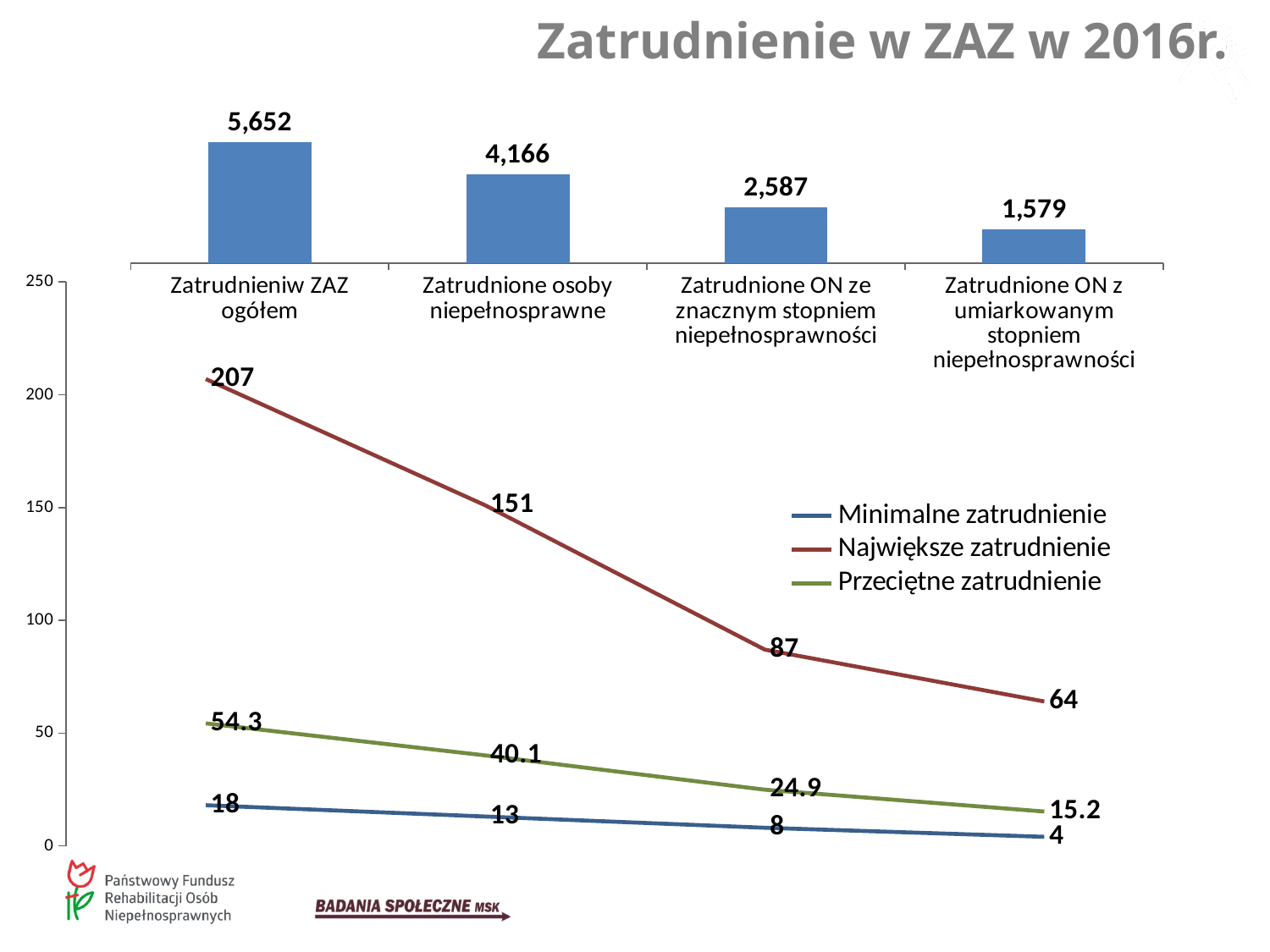
In the line chart at the bottom of the slide, which is larger at 'Zatrudnieniw ZAZ ogółem': 'Przeciętne zatrudnienie' or 'Minimalne zatrudnienie'? Przeciętne zatrudnienie In the bar chart at the top of the slide, what is the difference between 'Zatrudnieniw ZAZ ogółem' and 'Zatrudnione osoby niepełnosprawne'? 1,486 What kind of chart is the upper chart on the slide? bar chart In the line chart at the bottom of the slide, do the values of 'Największe zatrudnienie' rise or fall from left to right? fall In the line chart at the bottom of the slide, how many series does the legend list? 3 In the line chart at the bottom of the slide, what colour is the 'Największe zatrudnienie' line? red In the bar chart at the top of the slide, what is the value for 'Zatrudnione osoby niepełnosprawne'? 4,166 In the line chart at the bottom of the slide, what is the value of 'Największe zatrudnienie' at 'Zatrudnione ON ze znacznym stopniem niepełnosprawności'? 87 In the bar chart at the top of the slide, how many bars are there? 4 In the line chart at the bottom of the slide, what is the difference between the first and last values of 'Minimalne zatrudnienie'? 14 In the line chart at the bottom of the slide, what is the value of 'Przeciętne zatrudnienie' at 'Zatrudnione osoby niepełnosprawne'? 40.1 In the bar chart at the top of the slide, which category has the lowest value? Zatrudnione ON z umiarkowanym stopniem niepełnosprawności